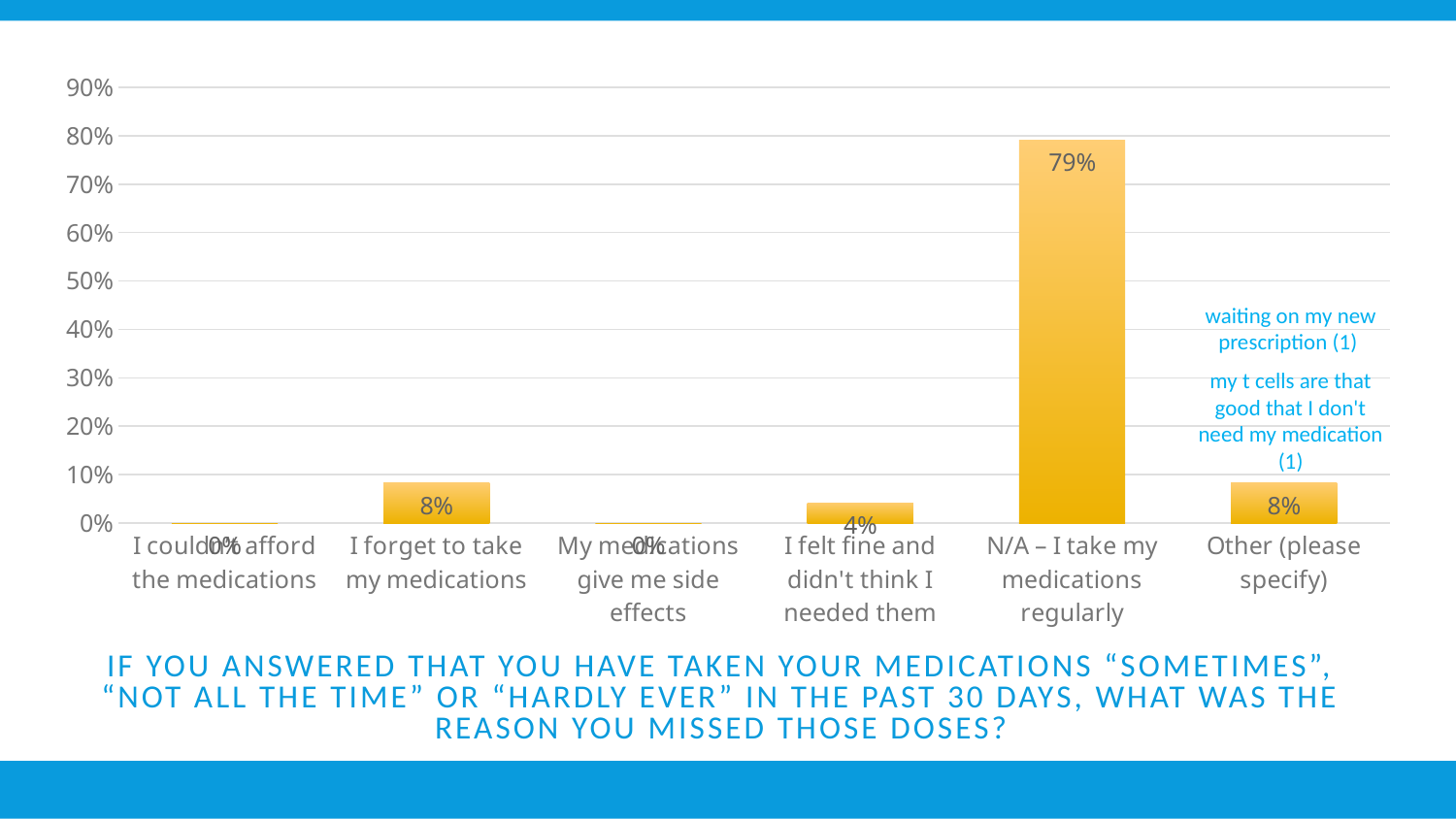
What percentage of respondents answered "N/A – I take my medications regularly"? 79% What is the difference between the values for "N/A – I take my medications regularly" and "Other (please specify)"? 71% What is the difference between the values for "I forget to take my medications" and "I felt fine and didn't think I needed them"? 4% Is the value for "N/A – I take my medications regularly" greater or less than 70%? greater What is the value for "I forget to take my medications"? 8% What is the highest value shown on the vertical axis? 90% Which is larger: the value for "I forget to take my medications" or the value for "I felt fine and didn't think I needed them"? I forget to take my medications What is the value for "I couldn't afford the medications"? 0% What is the value for "I felt fine and didn't think I needed them"? 4% How many categories are shown on the x axis? 6 What kind of chart is shown on the slide? bar chart Which category has the highest value? N/A – I take my medications regularly